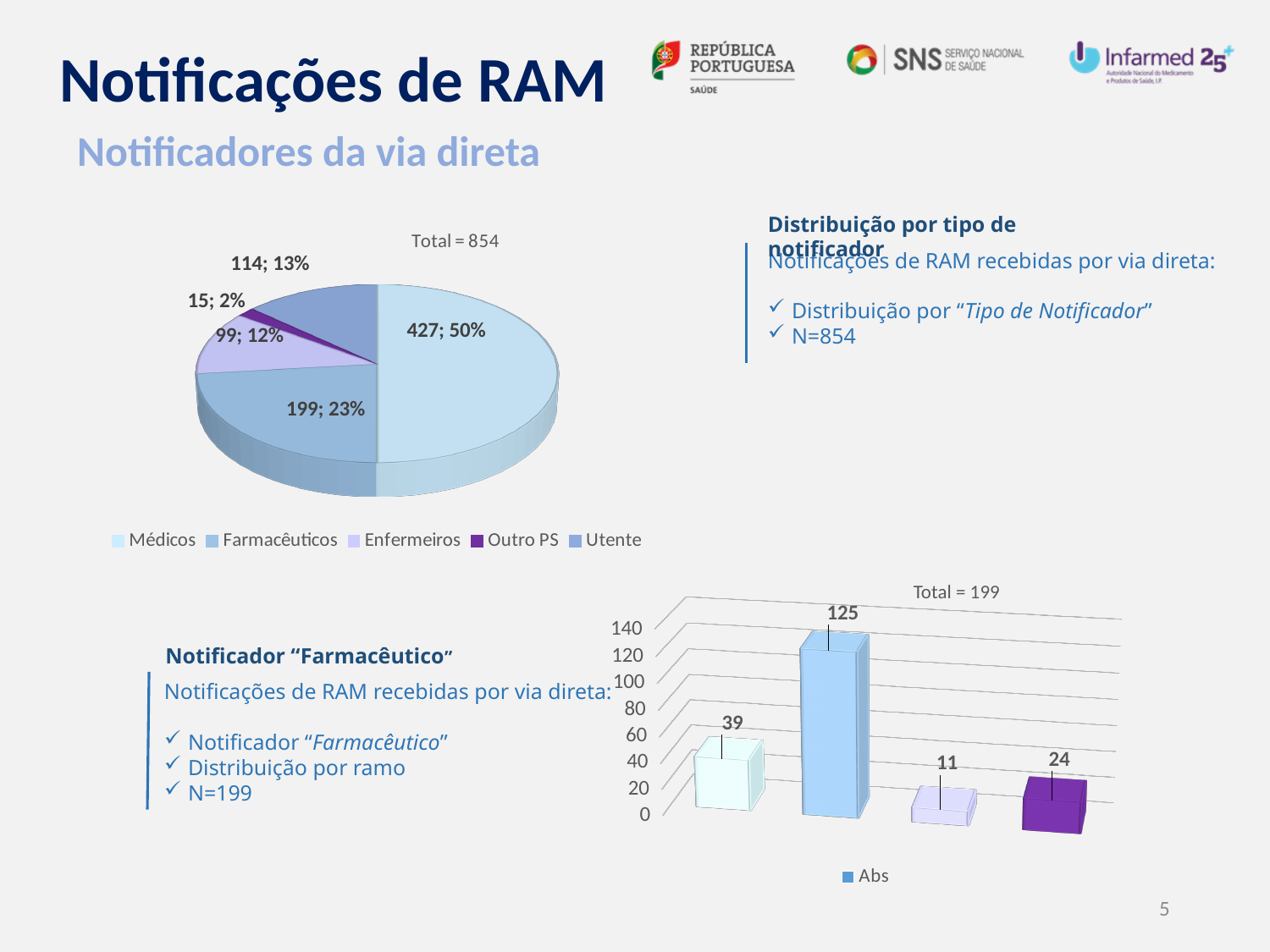
How many categories does the legend of the pie chart (Total = 854) list? 5 What kind of chart is the chart labelled Total = 199 at the bottom of the slide? bar chart In the pie chart (Total = 854), what value and percentage are shown for Farmacêuticos? 199; 23% In the pie chart (Total = 854), what is the difference between the values for Médicos and Farmacêuticos? 228 In the bar chart (Total = 199), what is the highest value shown on a bar? 125 In the pie chart (Total = 854), which is larger, the value for Utente or the value for Enfermeiros? Utente What is the name of the single series listed in the legend of the bar chart (Total = 199)? Abs In the pie chart (Total = 854), what percentage share does Enfermeiros have? 12% In the pie chart (Total = 854), what value and percentage are shown for Médicos? 427; 50% In the pie chart (Total = 854), which category has the largest slice? Médicos In the pie chart (Total = 854), which category has the smallest slice? Outro PS How many bars are plotted in the bar chart (Total = 199)? 4